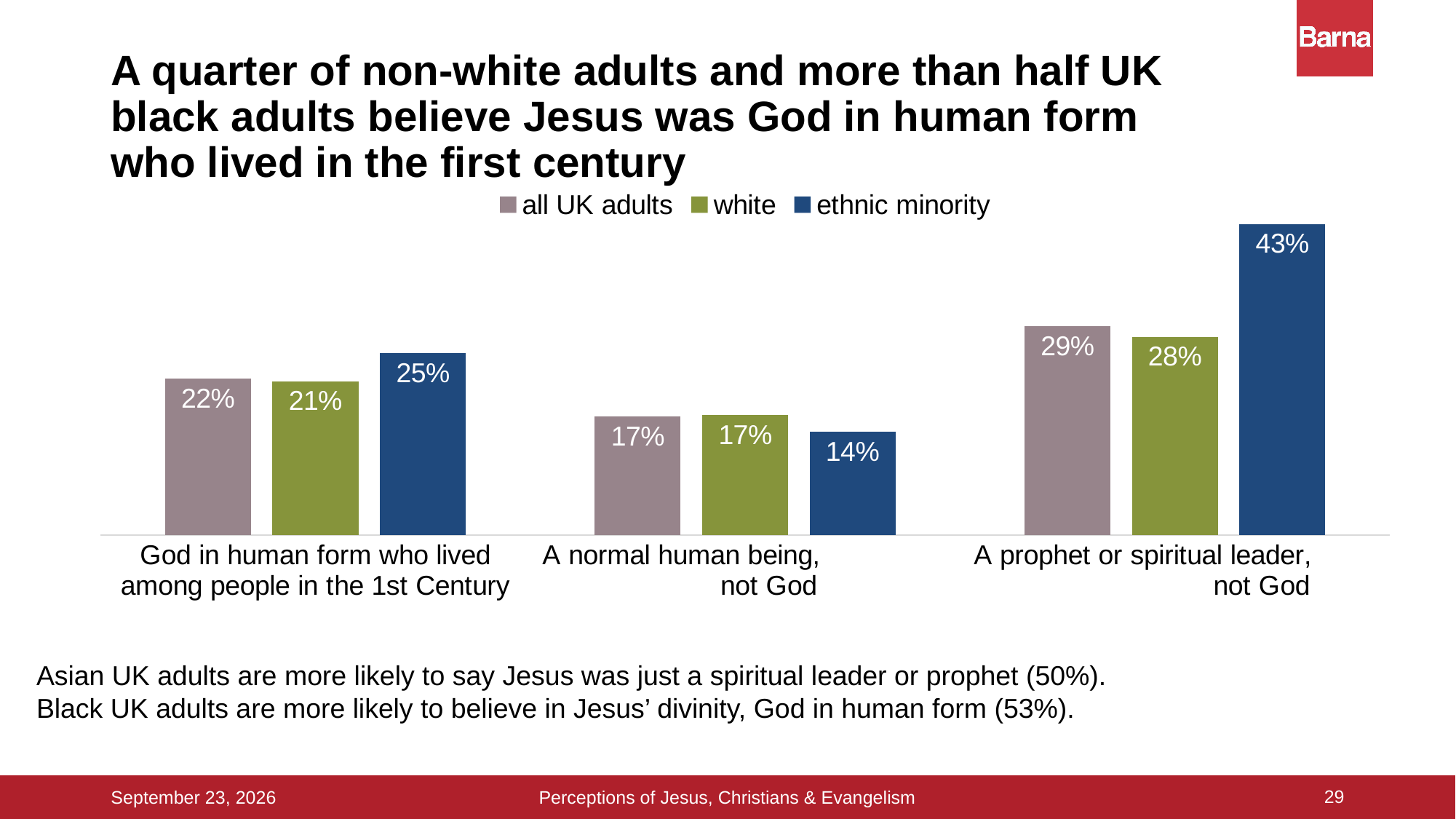
What kind of chart is shown on the slide? Bar chart What percentage of ethnic minority adults say Jesus was a prophet or spiritual leader, not God? 43% What is the difference between the ethnic minority and white values for 'A prophet or spiritual leader, not God'? 15 percentage points What is the value for all UK adults for 'God in human form who lived among people in the 1st Century'? 22% How many categories are shown on the x axis? 3 Which category has the highest value for ethnic minority adults? A prophet or spiritual leader, not God What is the difference between the ethnic minority and all UK adults values for 'God in human form who lived among people in the 1st Century'? 3 percentage points Which category has the lowest value for ethnic minority adults? A normal human being, not God What percentage of white adults say Jesus was a normal human being, not God? 17% For 'A normal human being, not God', which is larger: the value for white adults or for ethnic minority adults? white How many series does the legend list? 3 Which series is shown in blue in the legend? ethnic minority